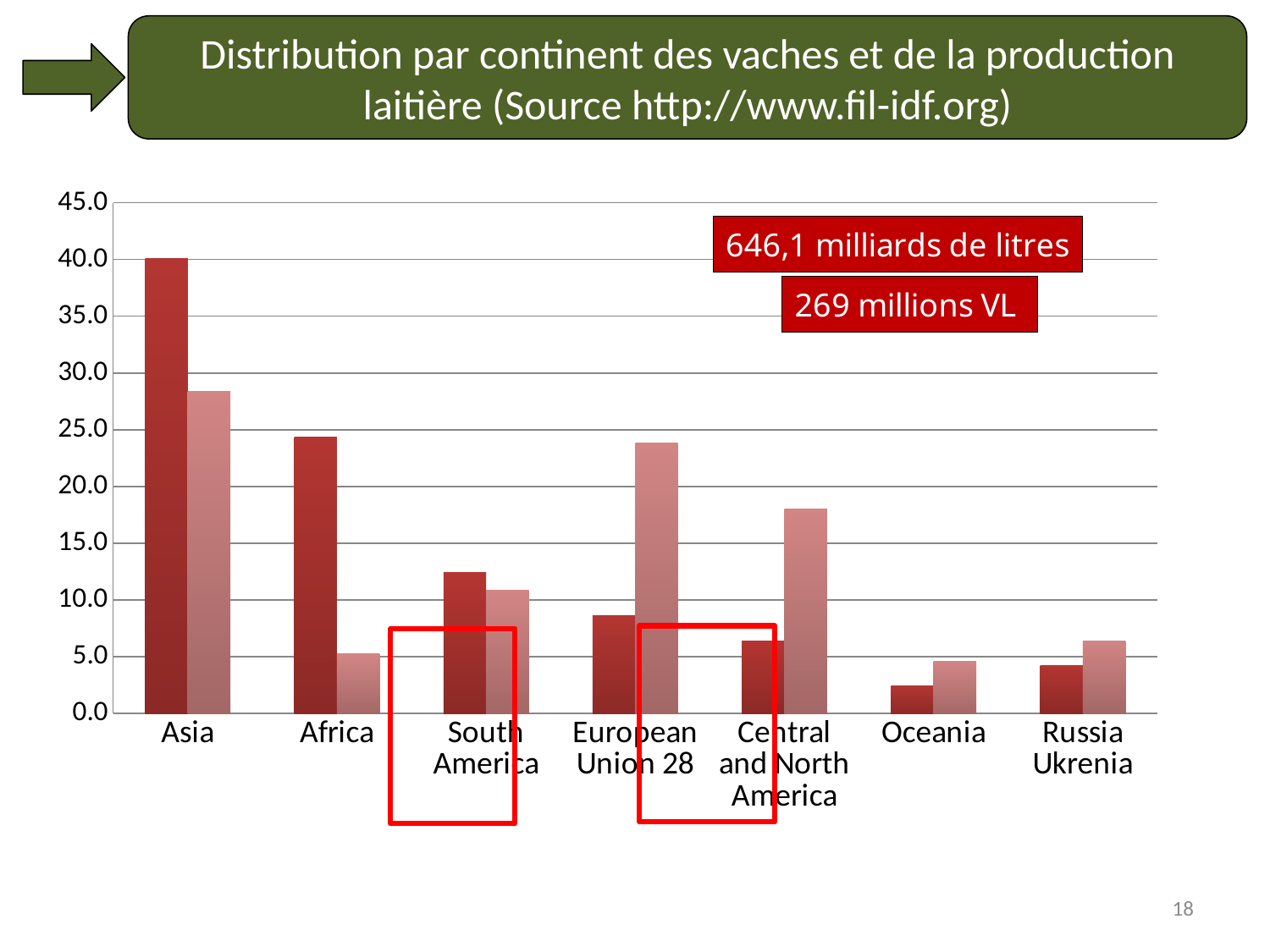
Is the light red bar for Africa greater or less than 10.0? less What kind of chart is shown on the slide? bar chart Which category has the shortest dark red bar? Oceania Which category has the shortest light red bar? Oceania How many bars are plotted for each category in the chart? 2 How many categories are shown on the x axis of the chart? 7 Is the dark red bar for Asia greater or less than 35.0? greater Is the light red bar for European Union 28 greater or less than 20.0? greater What is the title of the slide containing the chart? Distribution par continent des vaches et de la production laitière (Source http://www.fil-idf.org) Which category has the tallest dark red bar? Asia Which category has the tallest light red bar? Asia For Central and North America, which bar is taller, the dark red bar or the light red bar? the light red bar